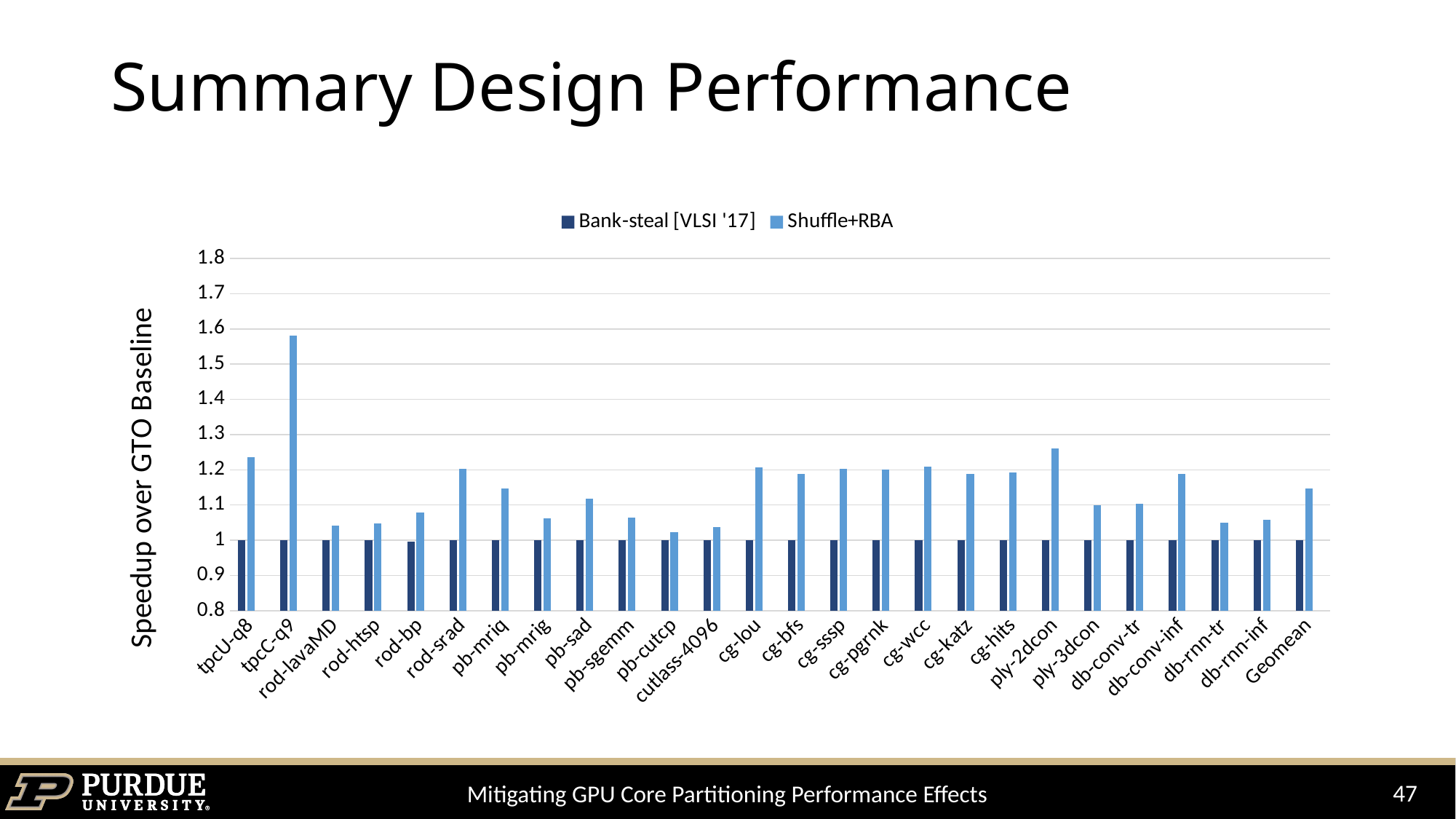
What is the label of the y axis? Speedup over GTO Baseline Is the Shuffle+RBA value for pb-cutcp greater or less than 1.1? less How many categories are shown along the x axis? 26 What kind of chart is shown on the slide? bar chart Is the Shuffle+RBA value for Geomean greater or less than 1.1? greater Is the Shuffle+RBA value for rod-bp greater or less than 1.1? less Which has the larger Shuffle+RBA value, rod-srad or rod-bp? rod-srad How many series does the legend list? 2 Which category has the highest Shuffle+RBA value? tpcC-q9 Which has the larger Shuffle+RBA value, ply-2dcon or ply-3dcon? ply-2dcon